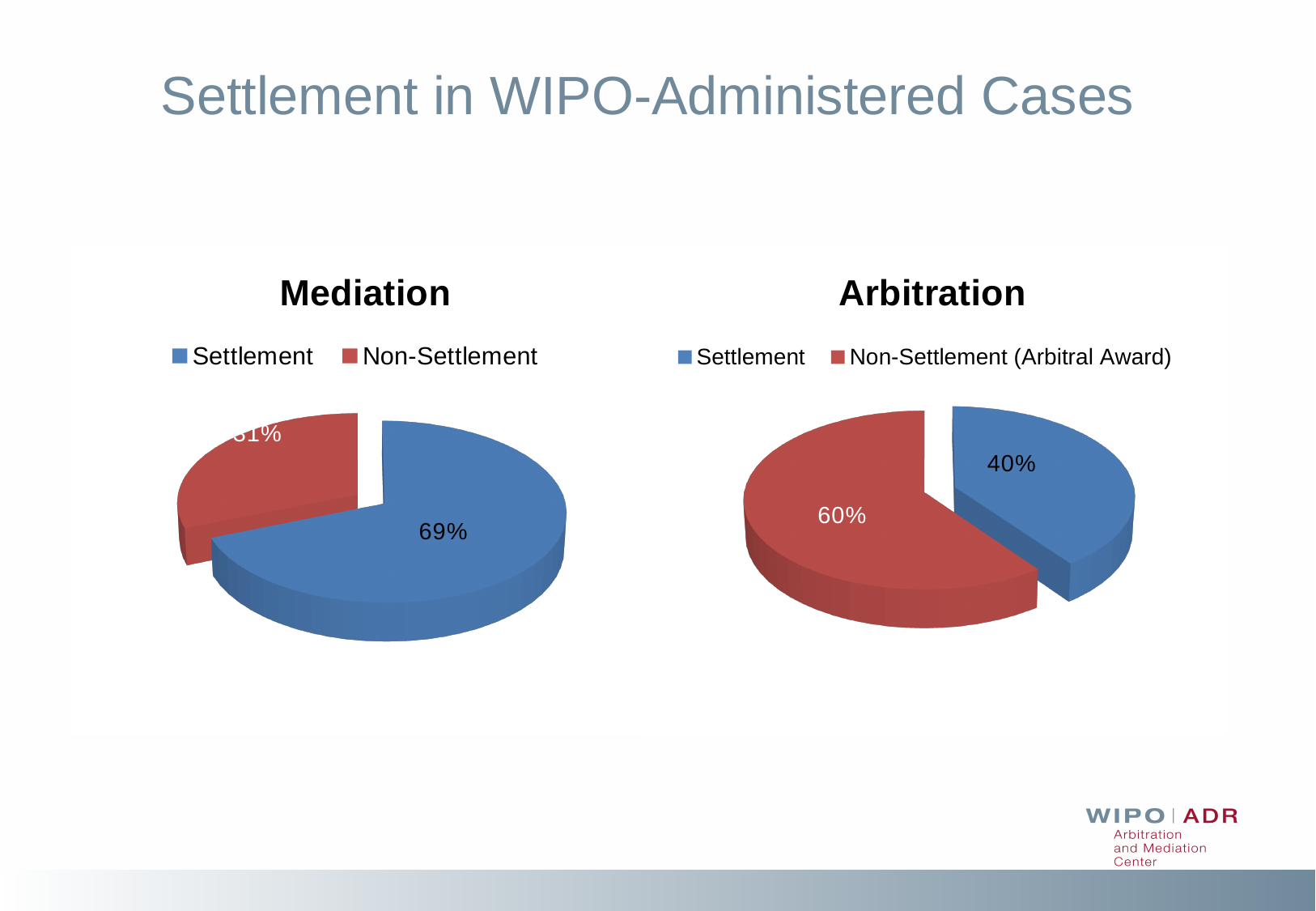
In the Arbitration chart, what share of cases ended in Settlement? 40% What is the title of the slide containing the two pie charts? Settlement in WIPO-Administered Cases In the Arbitration chart, what is the difference between the Non-Settlement (Arbitral Award) share and the Settlement share? 20% In the Arbitration chart, which slice is the smallest? Settlement Which chart shows a larger Settlement share, Mediation or Arbitration? Mediation In the Arbitration chart, what share of cases ended in Non-Settlement (Arbitral Award)? 60% How many entries does the legend of the Mediation chart list? 2 In the Mediation chart, which slice is the largest? Settlement In the Mediation chart, what share of cases ended in Non-Settlement? 31% How many slices does the Arbitration chart have? 2 In the Mediation chart, what share of cases ended in Settlement? 69% What type of chart is the Mediation chart? Pie chart